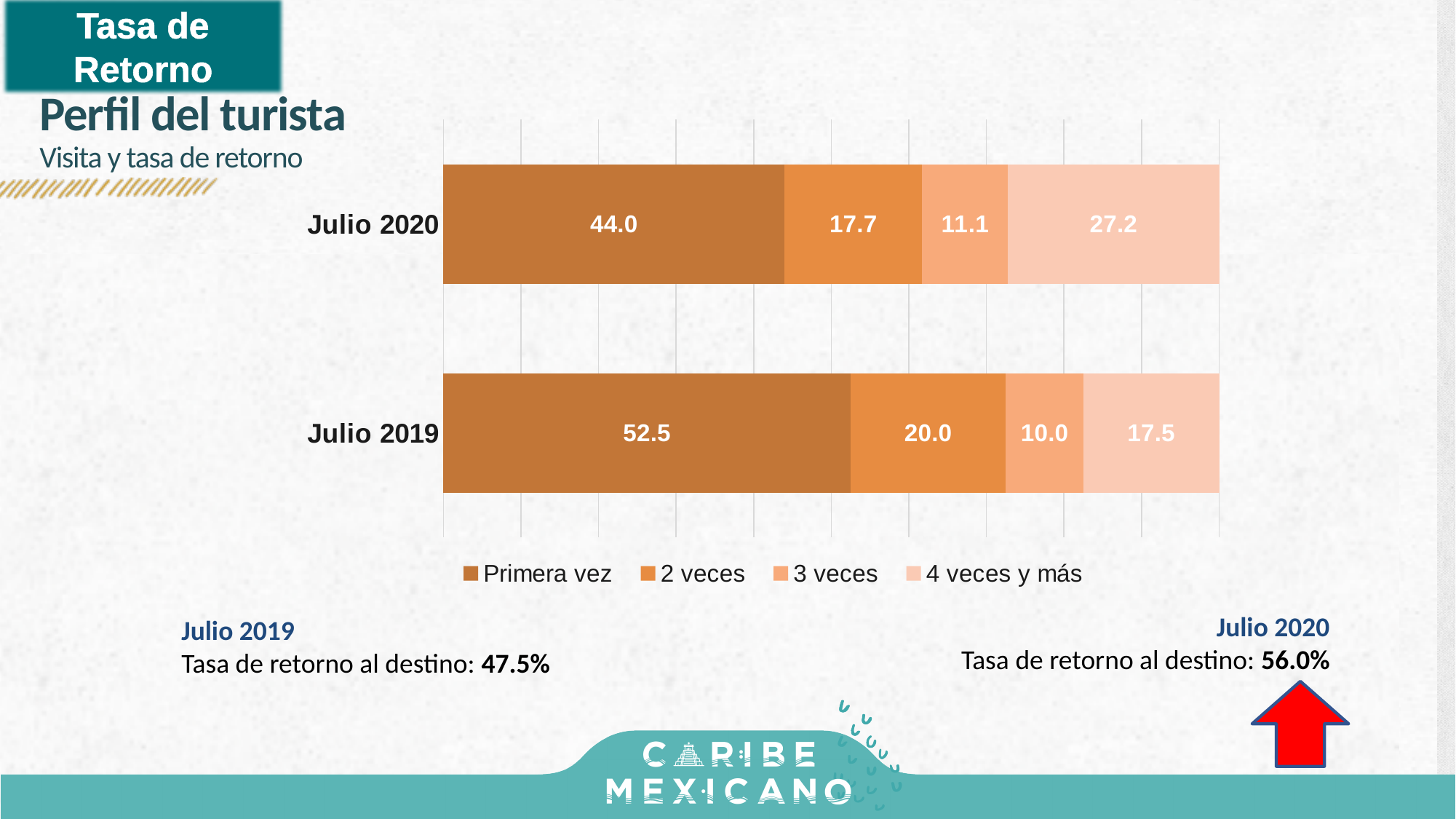
What kind of chart is shown on the slide? Stacked bar chart What is the value for "3 veces" in Julio 2020? 11.1 Which is larger, the "4 veces y más" value for Julio 2020 or for Julio 2019? Julio 2020 What is the value for "4 veces y más" in Julio 2019? 17.5 How many categories (bars) does the chart show? 2 What is the value for "2 veces" in Julio 2019? 20.0 What is the total of the Julio 2020 stacked bar? 100.0 Which series has the lowest value in the Julio 2020 bar? 3 veces What is the value for "Primera vez" in Julio 2020? 44.0 How many series does the legend list? 4 What is the difference between the "Primera vez" values for Julio 2019 and Julio 2020? 8.5 Which series has the highest value in the Julio 2019 bar? Primera vez